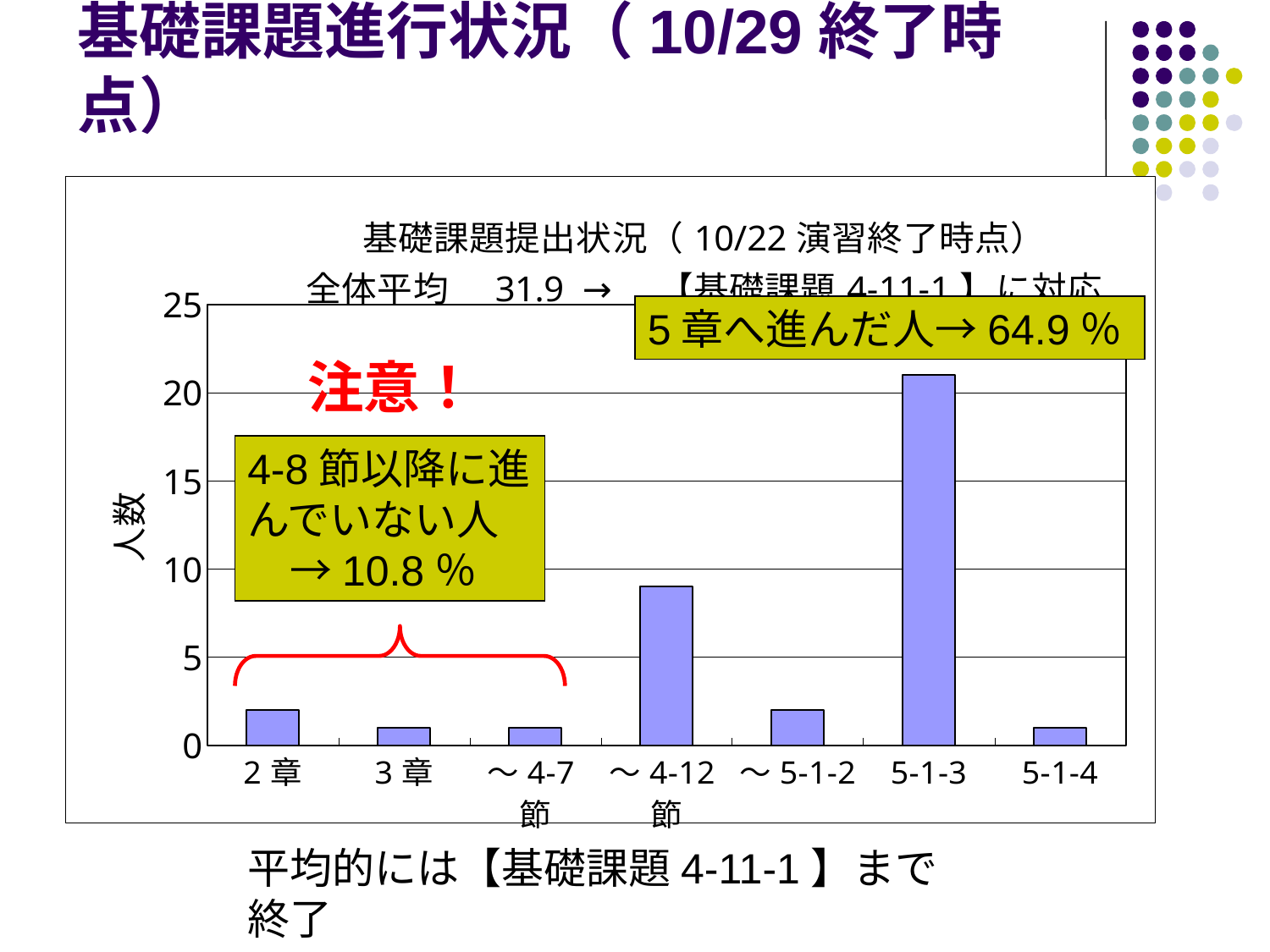
Which is larger, the value for ～4-12節 or the value for 3章? ～4-12節 Is the value for 2章 greater or less than 5? less Which category has the highest value in the chart? 5-1-3 What is the label of the y axis of the chart? 人数 Is the value for ～4-12節 greater or less than 10? less According to the annotation on the chart, what percentage of people have progressed to chapter 5 (5章へ進んだ人)? 64.9％ How many categories are shown on the x axis of the chart? 7 Which is larger, the value for 5-1-3 or the value for ～4-12節? 5-1-3 Is the value for 5-1-3 greater or less than 20? greater What kind of chart is shown on the slide? bar chart